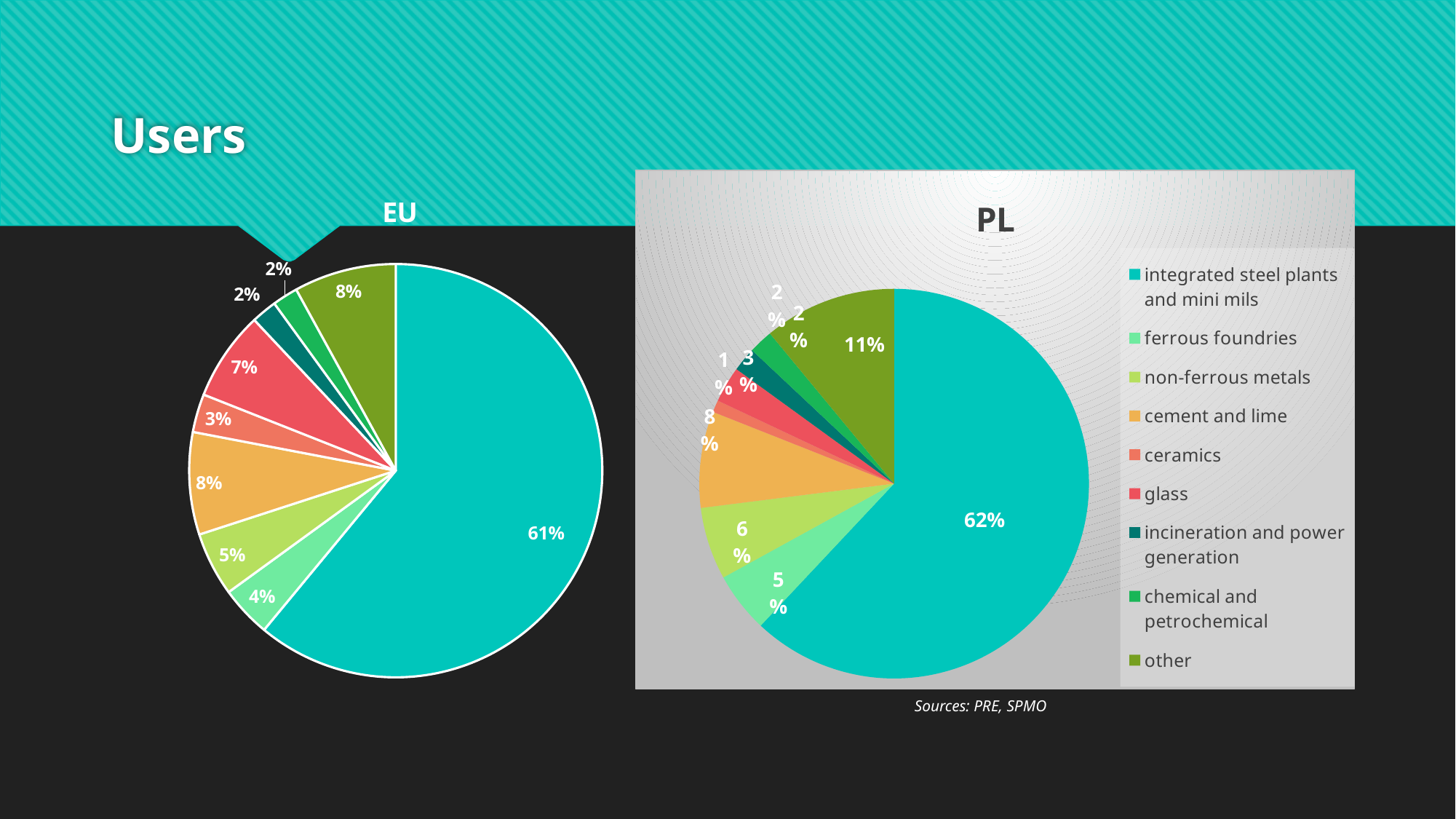
In the PL chart, what is the value for non-ferrous metals? 6% How many slices does the EU pie chart have? 9 In the PL chart, which is larger: ferrous foundries or glass? ferrous foundries In the PL chart, which category has the largest share? integrated steel plants and mini mils In the PL chart, what share do integrated steel plants and mini mils have? 62% What is the largest value shown in the EU chart? 61% In the PL chart, what is the value for the 'other' category? 11% What type of chart is used for the EU data? pie chart How many categories does the legend of the PL chart list? 9 In the PL chart, which category has the smallest share? ceramics In the PL chart, what is the difference between the shares of 'other' and cement and lime? 3% In the PL chart, what is the value for cement and lime? 8%